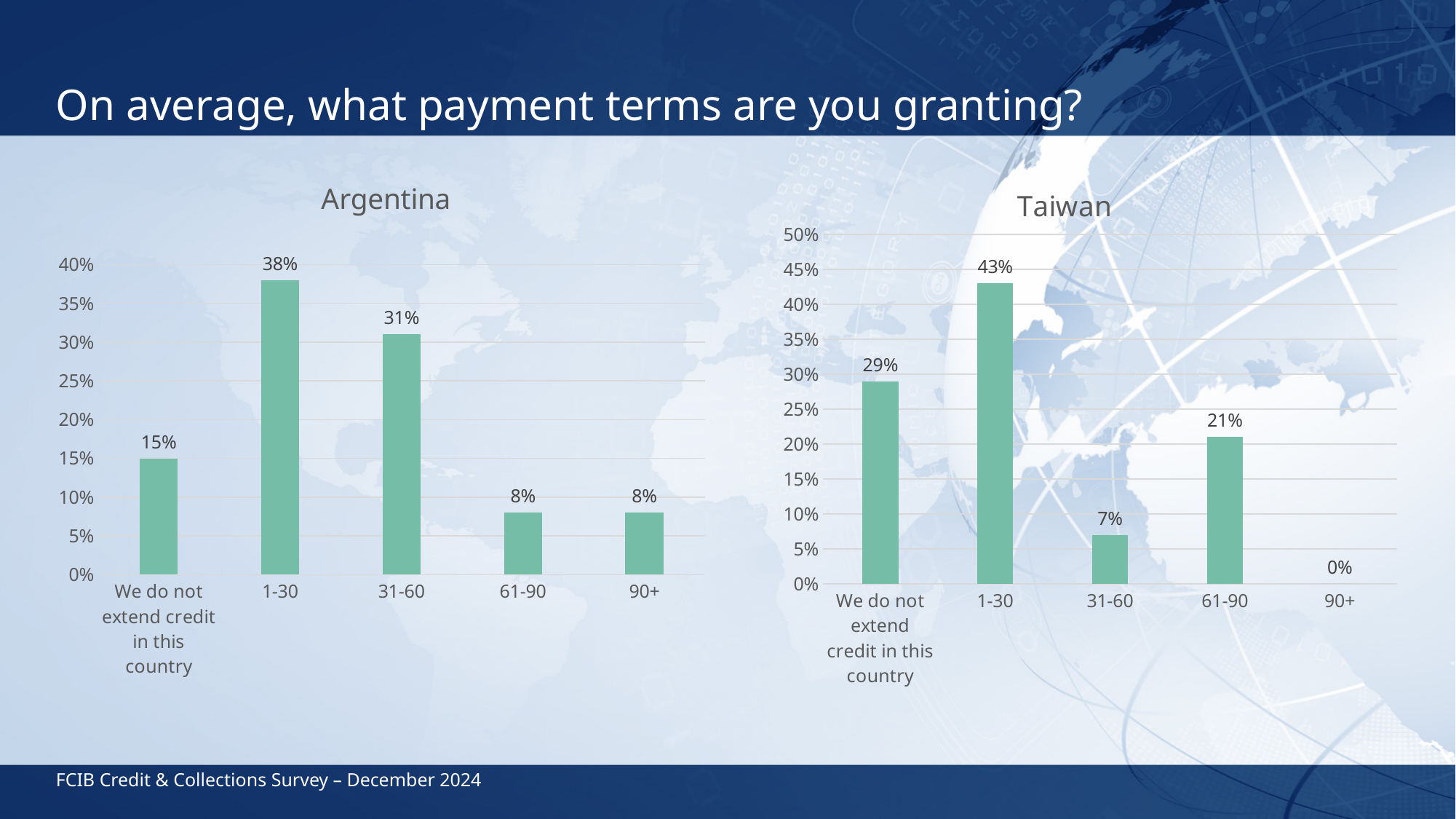
In the Taiwan chart, what is the value for 61-90? 21% What is the title of the chart on the right side of the slide? Taiwan What kind of chart is the Argentina chart? bar chart In the Taiwan chart, what is the difference between the values for 1-30 and 31-60? 36% In the Argentina chart, what is the value for 1-30? 38% In the Argentina chart, is the value for 31-60 greater or less than 25%? greater In the Argentina chart, which category has the highest value? 1-30 In the Taiwan chart, what is the value for 'We do not extend credit in this country'? 29% In the Argentina chart, what is the difference between the values for 1-30 and 31-60? 7% In the Taiwan chart, which is larger, the value for 'We do not extend credit in this country' or the value for 61-90? We do not extend credit in this country In the Taiwan chart, which category has the lowest value? 90+ How many categories are shown in the Taiwan chart? 5